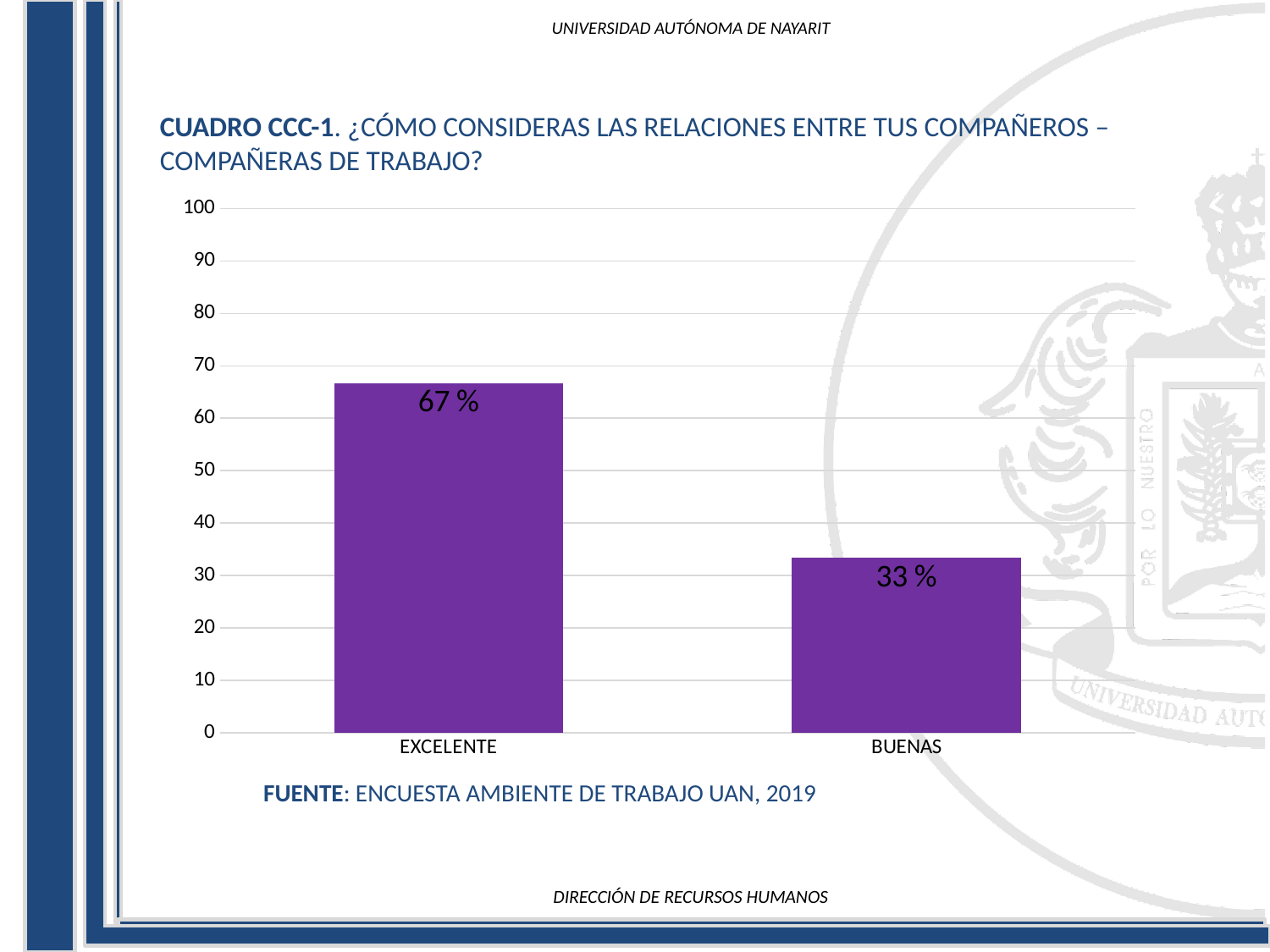
How many categories are shown on the x axis? 2 What source is cited below the chart? ENCUESTA AMBIENTE DE TRABAJO UAN, 2019 What is the difference between the values for EXCELENTE and BUENAS? 34 % Which category has the lowest value? BUENAS Which is larger, the value for EXCELENTE or the value for BUENAS? EXCELENTE Is the value for EXCELENTE greater or less than 60? greater Is the value for BUENAS greater or less than 40? less What is the value for EXCELENTE? 67 % What kind of chart is shown on the slide? bar chart Which category has the highest value? EXCELENTE What is the maximum value shown on the y axis? 100 What is the value for BUENAS? 33 %